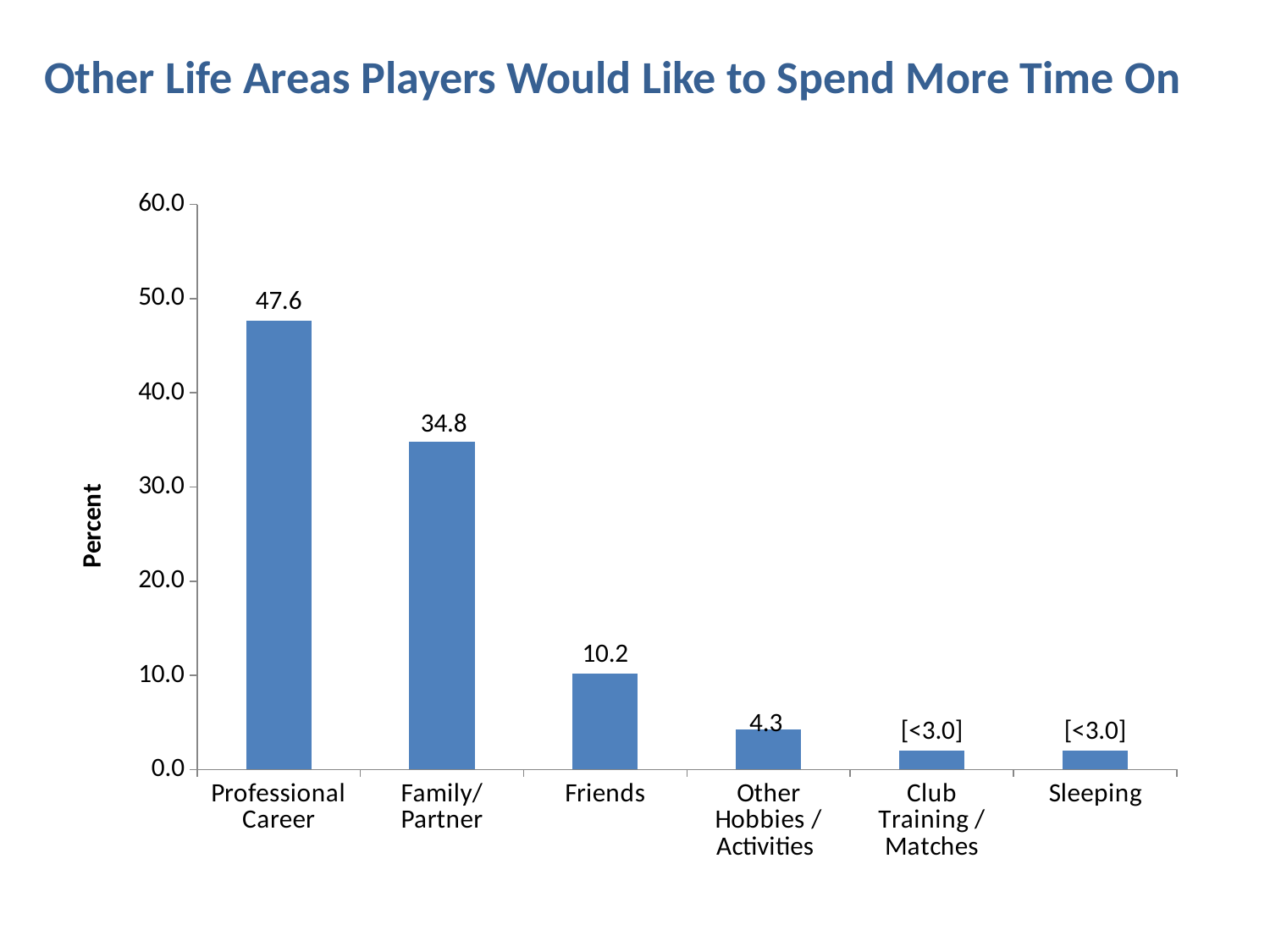
What is the difference between the values for Professional Career and Family/Partner? 12.8 Is the value for Club Training / Matches greater or less than 10.0? less What is the value for Other Hobbies / Activities? 4.3 What is the value for Professional Career? 47.6 What is the label of the vertical axis? Percent What kind of chart is shown on the slide? bar chart Which is larger, the value for Friends or the value for Other Hobbies / Activities? Friends What label is shown above the Sleeping bar? [<3.0] Which category has the highest value? Professional Career What is the value for Family/Partner? 34.8 What is the value for Friends? 10.2 How many categories are shown on the x axis? 6